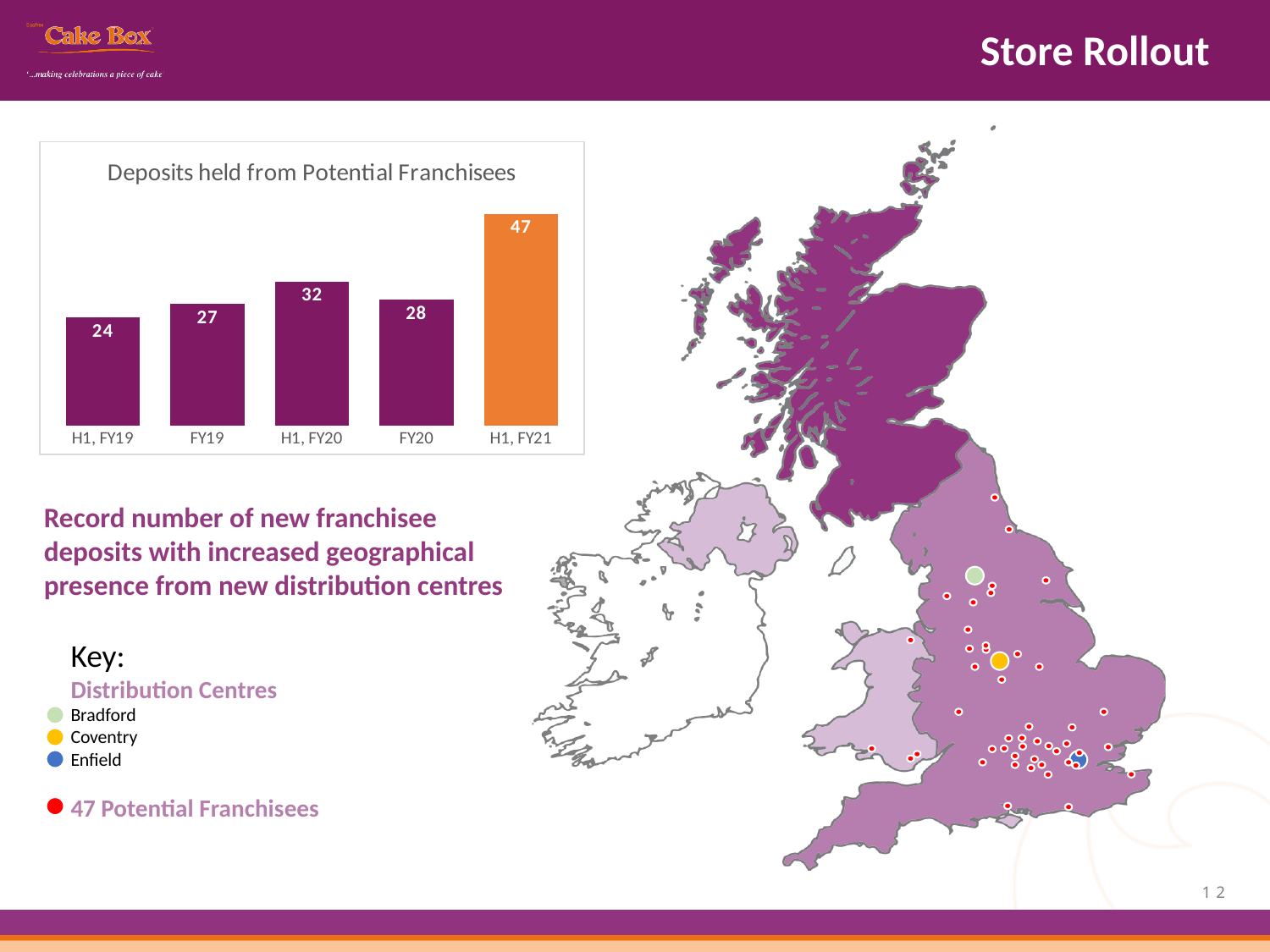
What is the title of the bar chart on the slide? Deposits held from Potential Franchisees What kind of chart is the Deposits held from Potential Franchisees chart? Bar chart Which is larger in the Deposits held from Potential Franchisees chart, H1, FY20 or FY20? H1, FY20 Which period has the lowest value in the Deposits held from Potential Franchisees chart? H1, FY19 What is the difference between the H1, FY20 and H1, FY19 values in the Deposits held from Potential Franchisees chart? 8 Which period has the highest value in the Deposits held from Potential Franchisees chart? H1, FY21 What is the value for FY19 in the Deposits held from Potential Franchisees chart? 27 What is the value for H1, FY20 in the Deposits held from Potential Franchisees chart? 32 What is the value for H1, FY21 in the Deposits held from Potential Franchisees chart? 47 Which bar in the Deposits held from Potential Franchisees chart is coloured orange rather than purple? H1, FY21 How many periods are shown in the Deposits held from Potential Franchisees chart? 5 What is the difference between the H1, FY21 and FY20 values in the Deposits held from Potential Franchisees chart? 19